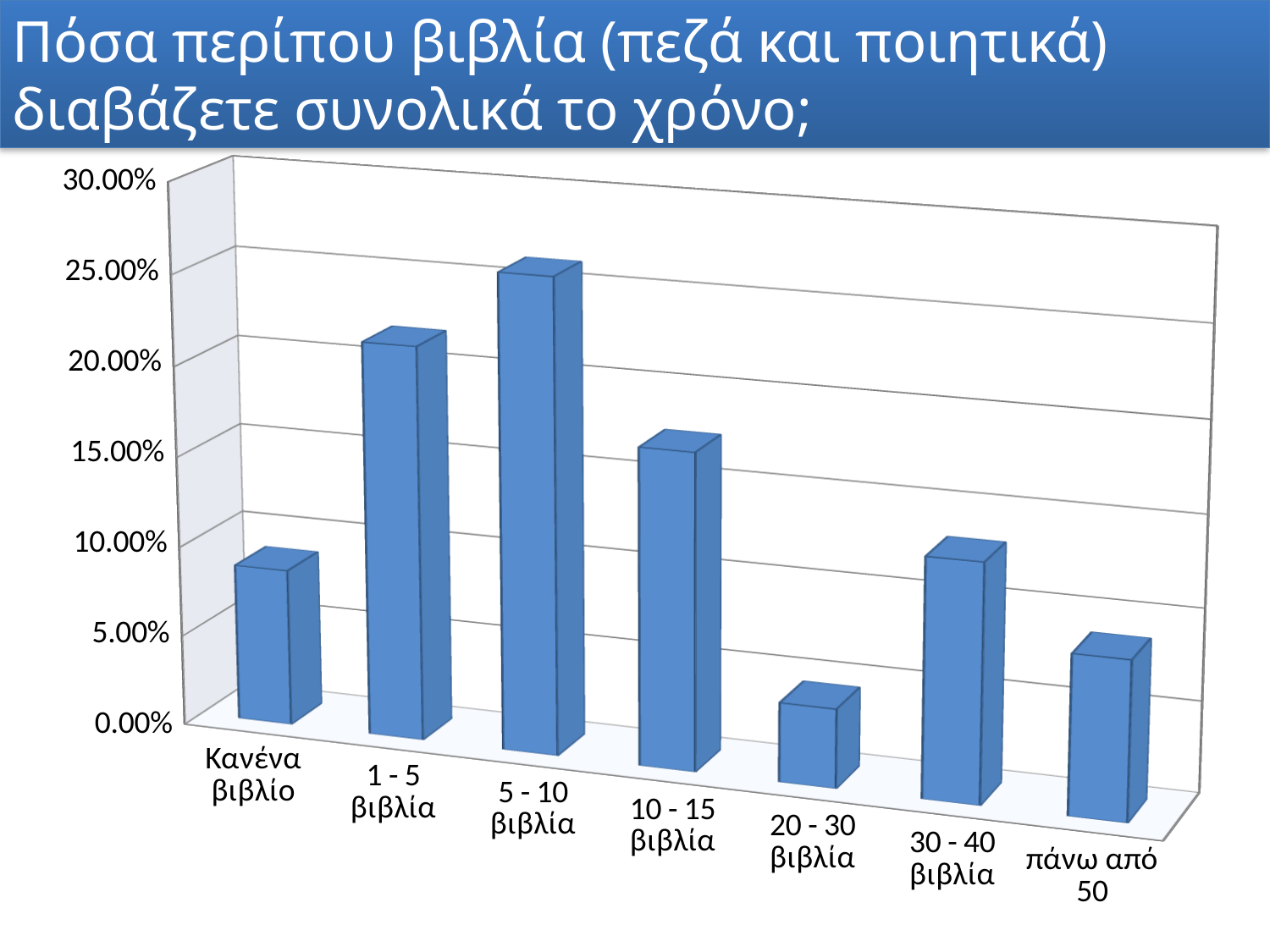
Is the value for Κανένα βιβλίο greater or less than 10.00%? less How many categories are shown on the x axis of the chart? 7 What is the title of the slide containing the chart? Πόσα περίπου βιβλία (πεζά και ποιητικά) διαβάζετε συνολικά το χρόνο; Which is larger, the value for 1 - 5 βιβλία or the value for 10 - 15 βιβλία? 1 - 5 βιβλία Which category has the highest value in the chart? 5 - 10 βιβλία Which category has the lowest value in the chart? 20 - 30 βιβλία Is the value for 1 - 5 βιβλία greater or less than 15.00%? greater Is the value for 20 - 30 βιβλία greater or less than 5.00%? less Which is larger, the value for 30 - 40 βιβλία or the value for πάνω από 50? 30 - 40 βιβλία What kind of chart is shown on the slide? Bar chart